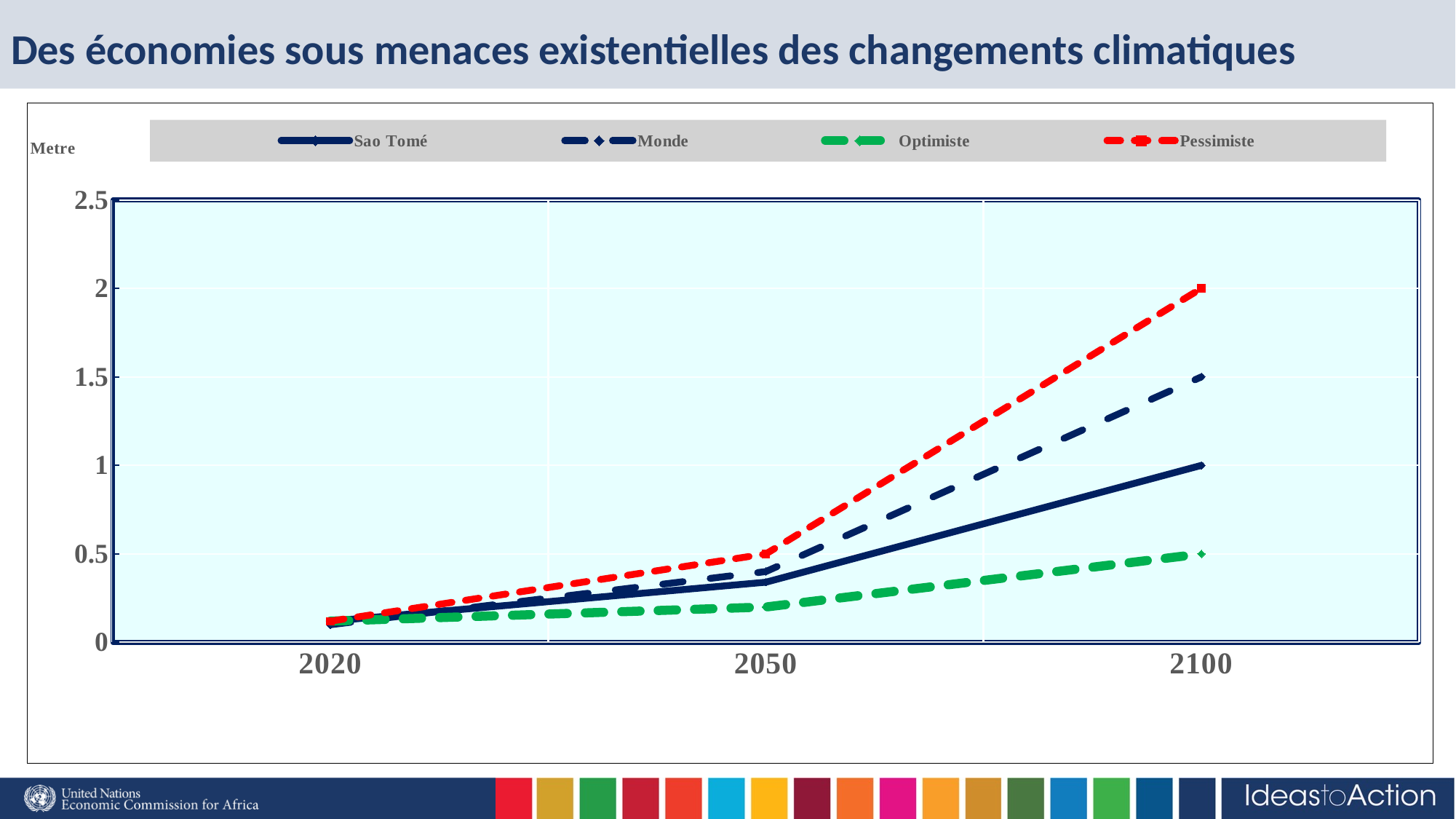
How many series does the legend list? 4 What is the value of the Sao Tomé series in 2100? 1 What unit is shown on the y axis label? Metre What kind of chart is shown on the slide? line chart Is the value of the Sao Tomé series in 2050 greater or less than 0.5? less What is the value of the Optimiste series in 2100? 0.5 How many years are labelled on the x axis? 3 What is the value of the Pessimiste series in 2100? 2 Which series has the highest value in 2100? Pessimiste What is the value of the Monde series in 2100? 1.5 Which series has the lowest value in 2100? Optimiste What is the difference between the Pessimiste and Optimiste values in 2100? 1.5